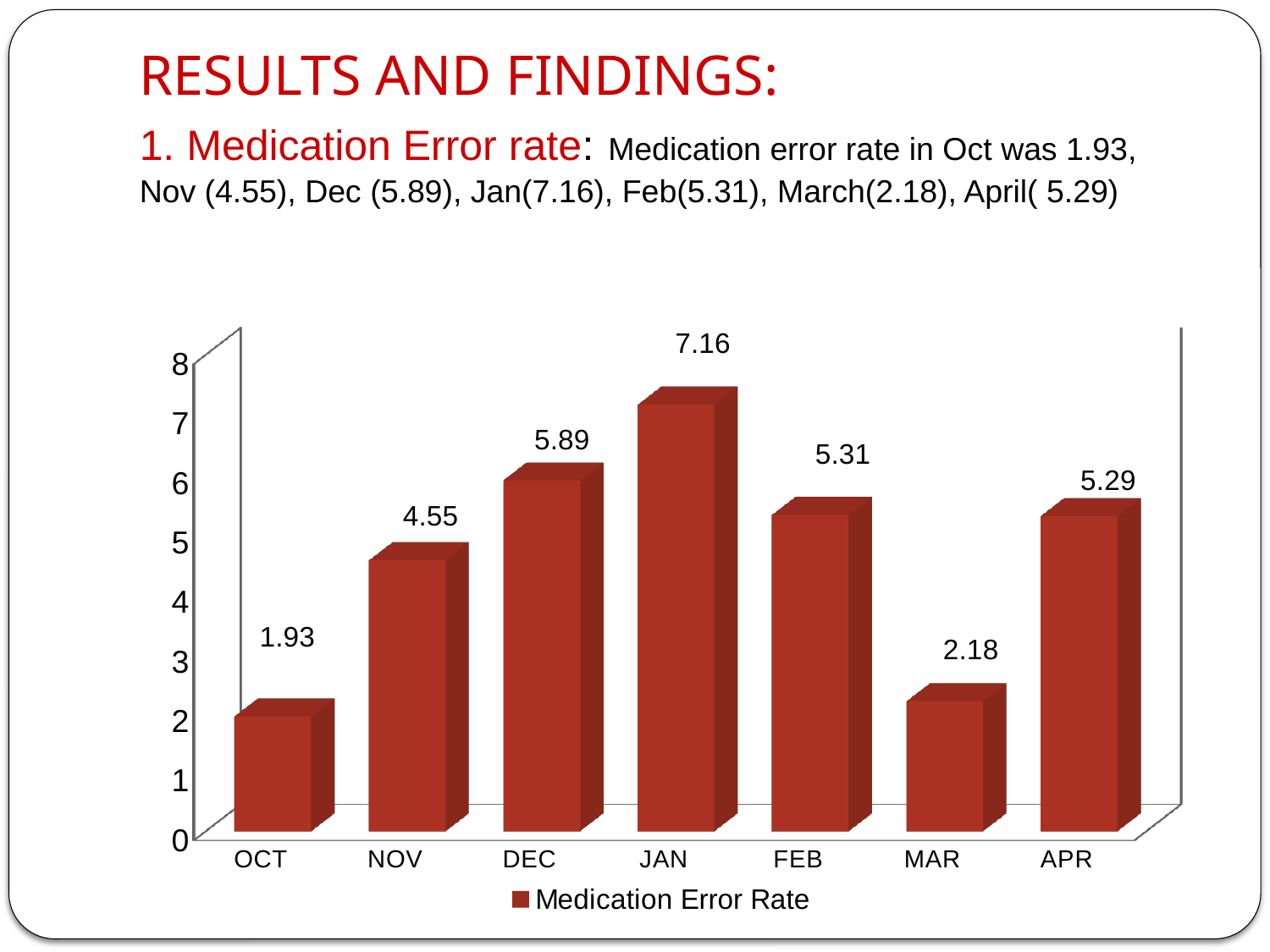
What kind of chart is shown on the slide? bar chart What is the difference between the Medication Error Rate in DEC and in NOV? 1.34 Which month has a higher Medication Error Rate, DEC or FEB? DEC Which month has the lowest Medication Error Rate? OCT How many series does the chart legend list? 1 What is the difference between the Medication Error Rate in JAN and in OCT? 5.23 What is the Medication Error Rate for OCT? 1.93 Which month has the highest Medication Error Rate? JAN What is the Medication Error Rate for APR? 5.29 How many months are shown on the x axis of the chart? 7 What is the Medication Error Rate for JAN? 7.16 Is the Medication Error Rate for MAR greater or less than 3? less